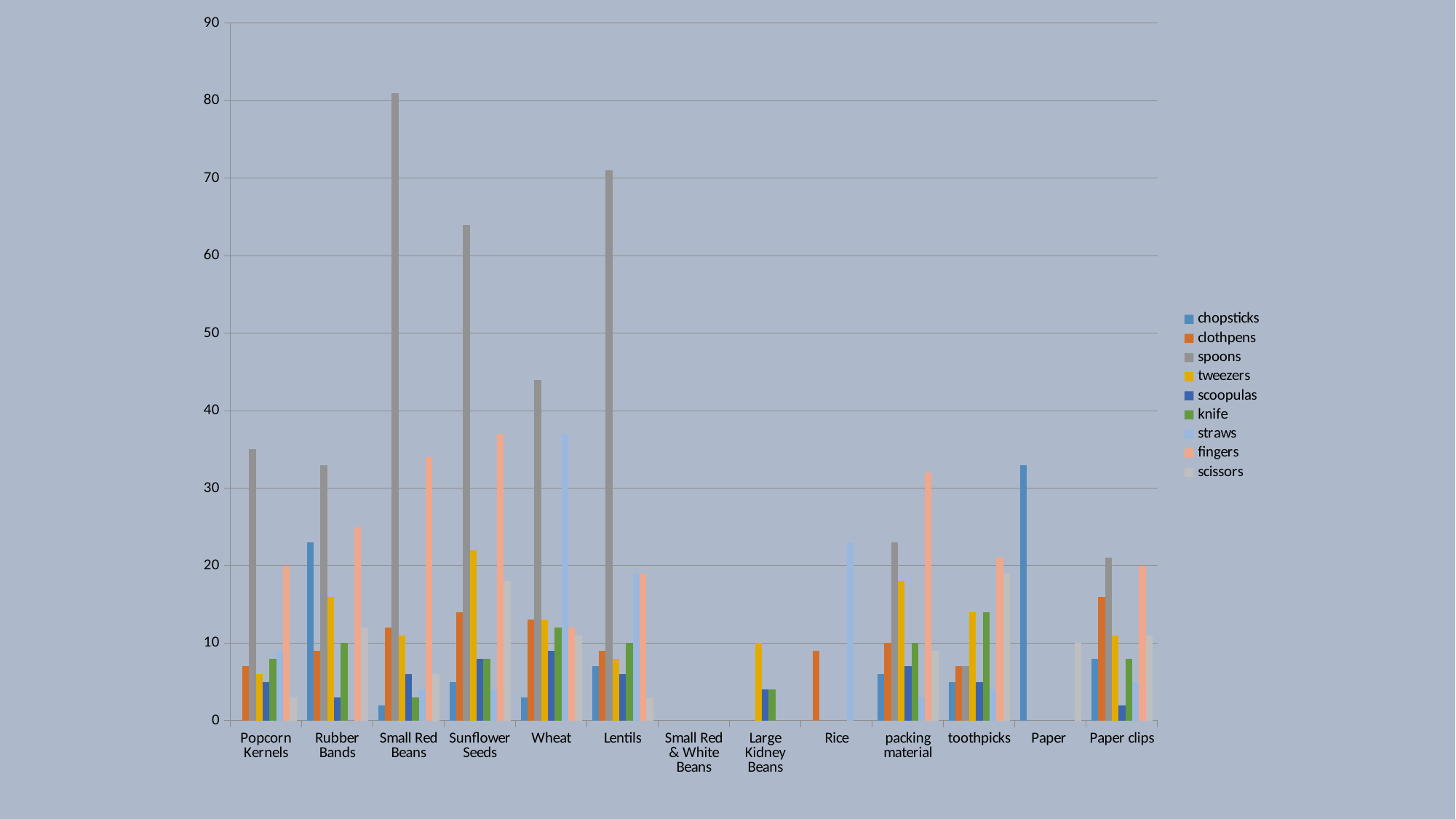
Is the value for spoons for Wheat greater or less than 50? less Which is larger, the spoons value for Lentils or the spoons value for Wheat? Lentils Which category has the highest value for spoons? Small Red Beans Is the value for chopsticks for Paper greater or less than 30? greater How many series does the legend list? 9 Which series is listed last in the legend? scissors Is the value for straws for Rice greater or less than 20? greater Which category has the highest value for chopsticks? Paper How many categories are shown along the x axis? 13 What kind of chart is shown on the slide? bar chart